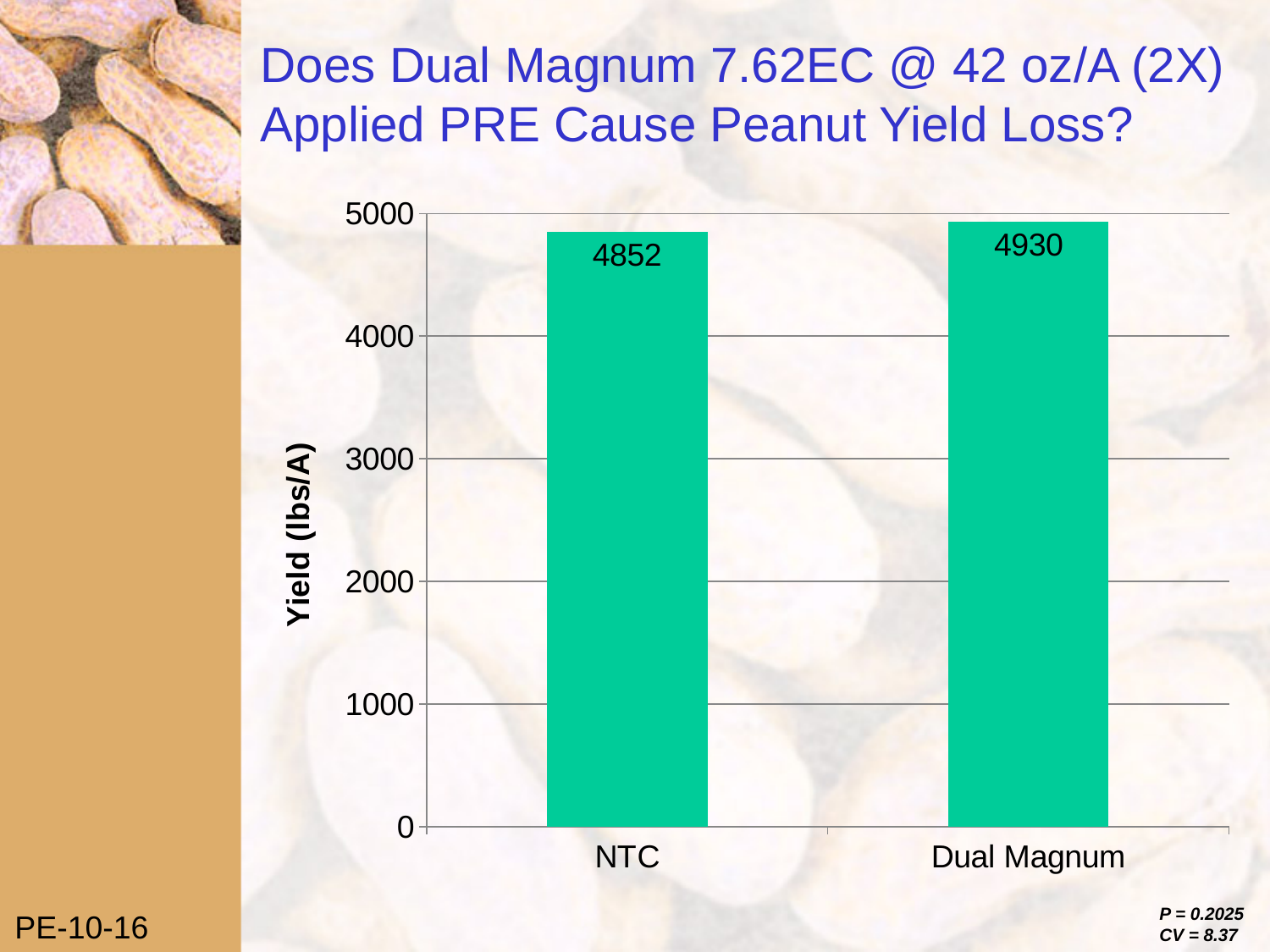
What kind of chart is shown on the slide? bar chart Which category has the lower yield? NTC What is the difference in yield between Dual Magnum and NTC? 78 Which category has the higher yield? Dual Magnum Is the yield for NTC greater or less than 4000? greater Is the yield for Dual Magnum greater or less than 5000? less What is the maximum value shown on the y axis? 5000 How many categories are shown on the x axis? 2 What is the label of the y axis? Yield (lbs/A) What is the yield for NTC? 4852 What is the yield for Dual Magnum? 4930